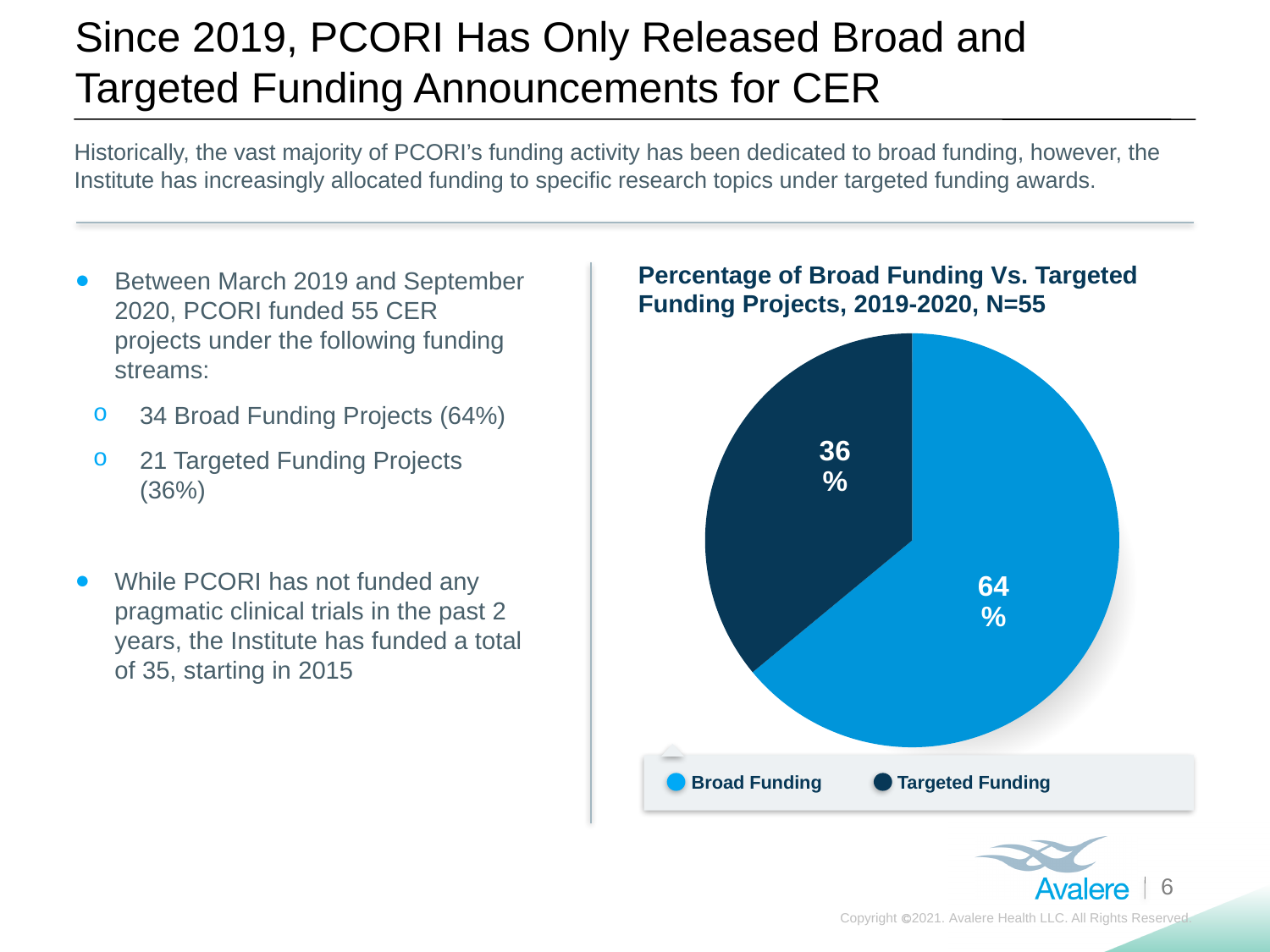
What percentage of the pie chart is Targeted Funding? 36% How many slices does the pie chart have? 2 How many entries does the legend of the pie chart list? 2 Which slice of the pie chart is the largest? Broad Funding What is the title of the pie chart? Percentage of Broad Funding Vs. Targeted Funding Projects, 2019-2020, N=55 Which is larger in the pie chart, Broad Funding or Targeted Funding? Broad Funding What percentage of the pie chart is Broad Funding? 64% What is the difference in percentage points between the Broad Funding and Targeted Funding slices? 28 What share of the pie does the Targeted Funding slice represent? 36% What type of chart is shown on the slide? Pie chart What is the total N stated in the pie chart title? N=55 Which slice of the pie chart is the smallest? Targeted Funding